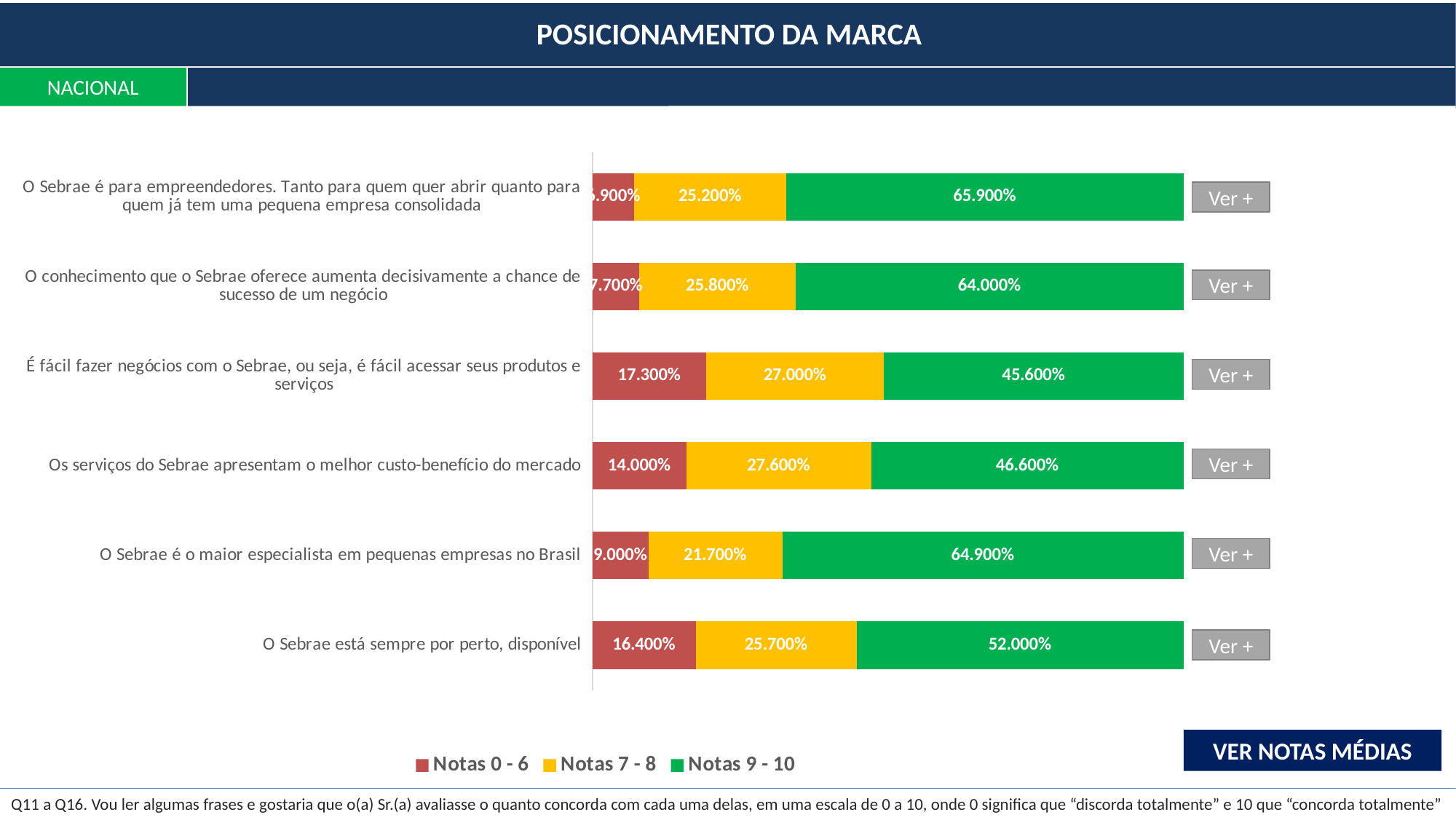
How many statements (categories) are plotted in the chart? 6 What is the difference between the 'Notas 9 - 10' values for 'O Sebrae é o maior especialista em pequenas empresas no Brasil' and 'O Sebrae está sempre por perto, disponível'? 12.900% Which colour represents the 'Notas 0 - 6' series in the chart? Red What is the value of 'Notas 7 - 8' for 'Os serviços do Sebrae apresentam o melhor custo-benefício do mercado'? 27.600% Which is larger: the 'Notas 0 - 6' value for 'É fácil fazer negócios com o Sebrae, ou seja, é fácil acessar seus produtos e serviços' or for 'Os serviços do Sebrae apresentam o melhor custo-benefício do mercado'? É fácil fazer negócios com o Sebrae, ou seja, é fácil acessar seus produtos e serviços Which statement has the highest 'Notas 9 - 10' value? O Sebrae é para empreendedores. Tanto para quem quer abrir quanto para quem já tem uma pequena empresa consolidada What is the value of 'Notas 0 - 6' for 'É fácil fazer negócios com o Sebrae, ou seja, é fácil acessar seus produtos e serviços'? 17.300% What kind of chart is shown on the slide? Stacked bar chart Which statement has the lowest 'Notas 9 - 10' value? É fácil fazer negócios com o Sebrae, ou seja, é fácil acessar seus produtos e serviços What is the value of 'Notas 9 - 10' for 'O Sebrae está sempre por perto, disponível'? 52.000% How many series does the legend list? 3 What is the value of 'Notas 9 - 10' for 'O Sebrae é para empreendedores. Tanto para quem quer abrir quanto para quem já tem uma pequena empresa consolidada'? 65.900%